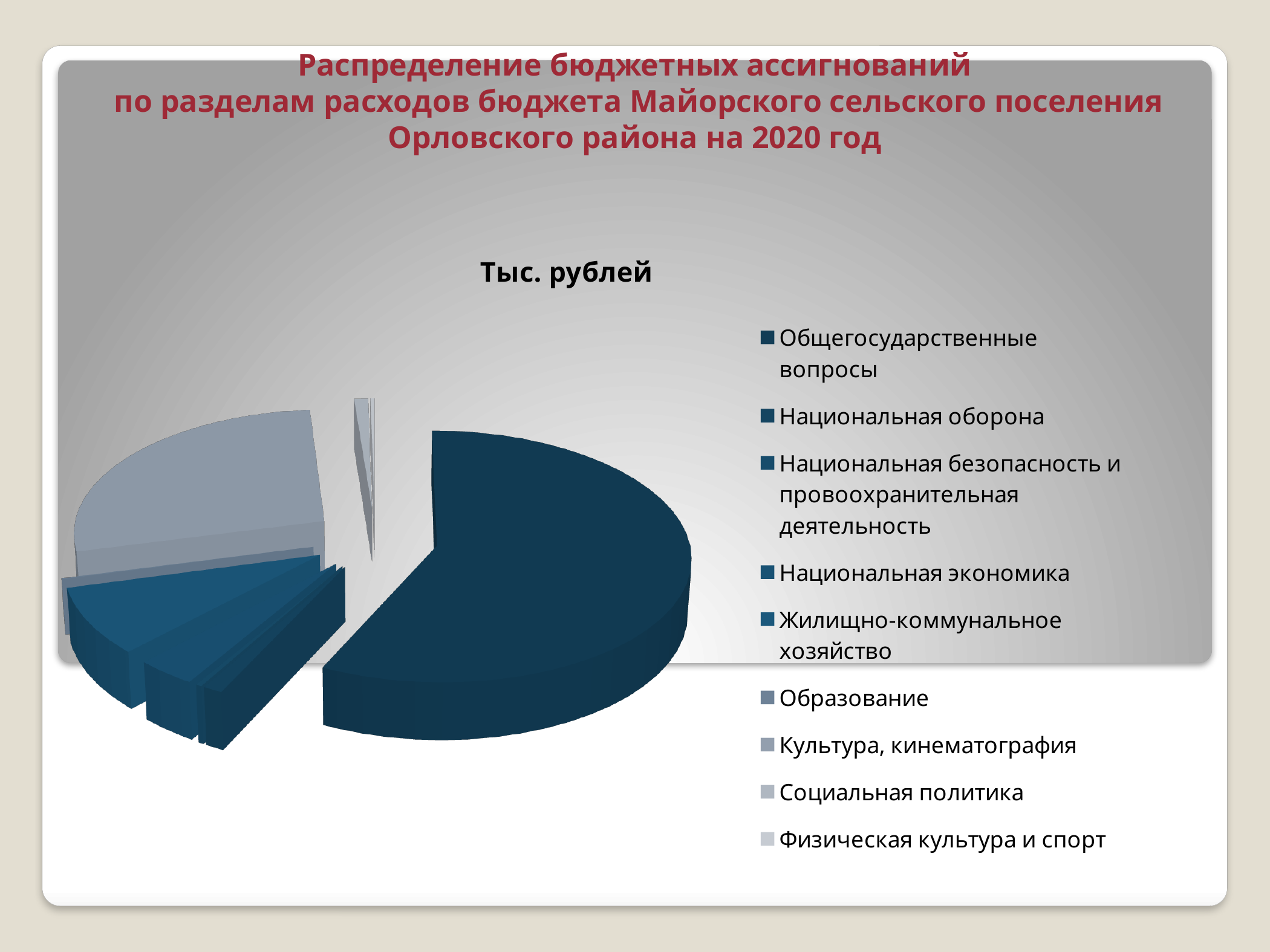
Which is larger in the pie chart: the slice for Общегосударственные вопросы or the slice for Физическая культура и спорт? Общегосударственные вопросы What is the title shown above the pie chart? Тыс. рублей How many categories does the legend of the pie chart list? 9 What kind of chart is shown on the slide? pie chart Which category has the largest slice in the pie chart? Общегосударственные вопросы What is the first entry listed in the pie chart's legend? Общегосударственные вопросы Which is larger in the pie chart: the slice for Общегосударственные вопросы or the slice for Национальная оборона? Общегосударственные вопросы